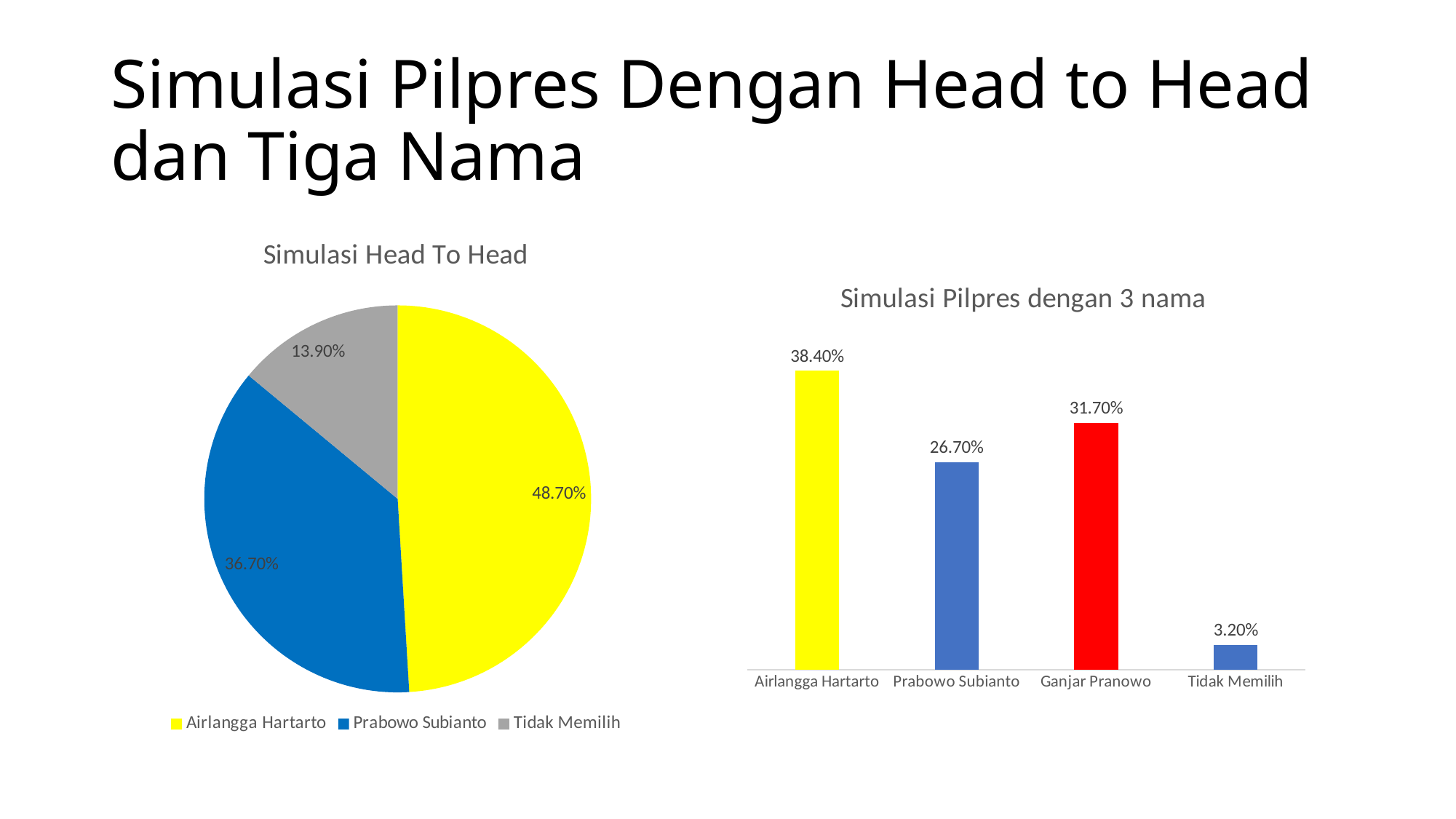
In the 'Simulasi Pilpres dengan 3 nama' chart, what is the value for Tidak Memilih? 3.20% In the 'Simulasi Head To Head' chart, what share does Airlangga Hartarto have? 48.70% How many entries does the legend of the 'Simulasi Head To Head' chart list? 3 What kind of chart is 'Simulasi Pilpres dengan 3 nama'? Bar chart In the 'Simulasi Pilpres dengan 3 nama' chart, what is the value for Ganjar Pranowo? 31.70% In the 'Simulasi Head To Head' chart, which category has the smallest slice? Tidak Memilih What kind of chart is 'Simulasi Head To Head'? Pie chart In the 'Simulasi Pilpres dengan 3 nama' chart, which category has the highest value? Airlangga Hartarto In the 'Simulasi Head To Head' chart, what share does Prabowo Subianto have? 36.70% In the 'Simulasi Pilpres dengan 3 nama' chart, which is larger: Prabowo Subianto or Ganjar Pranowo? Ganjar Pranowo In the 'Simulasi Head To Head' chart, what is the difference between Airlangga Hartarto and Prabowo Subianto? 12.00% How many categories are shown in the 'Simulasi Pilpres dengan 3 nama' chart? 4